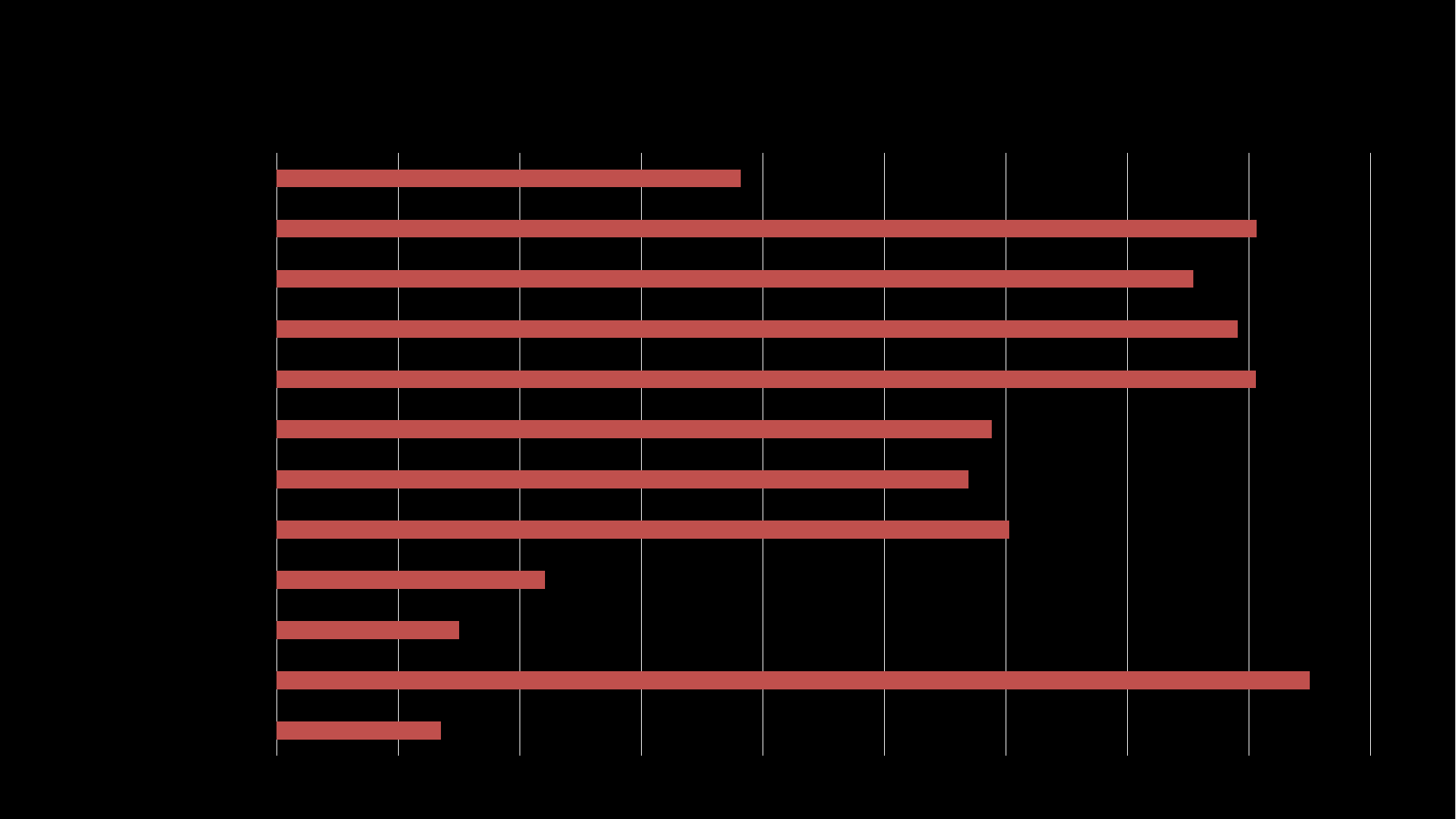
What colour are the bars in the chart? red Counting from the top, which bar is the longest in the chart? the eleventh bar What kind of chart is shown on the slide? bar chart Which is longer, the ninth bar from the top or the tenth bar from the top? the ninth bar Counting from the top, which bar is the shortest in the chart? the twelfth (bottom) bar Which is longer, the first bar from the top or the second bar from the top? the second bar Are the bars in the chart drawn horizontally or vertically? horizontally How many bars are plotted in the chart? 12 Which is longer, the sixth bar from the top or the eighth bar from the top? the eighth bar